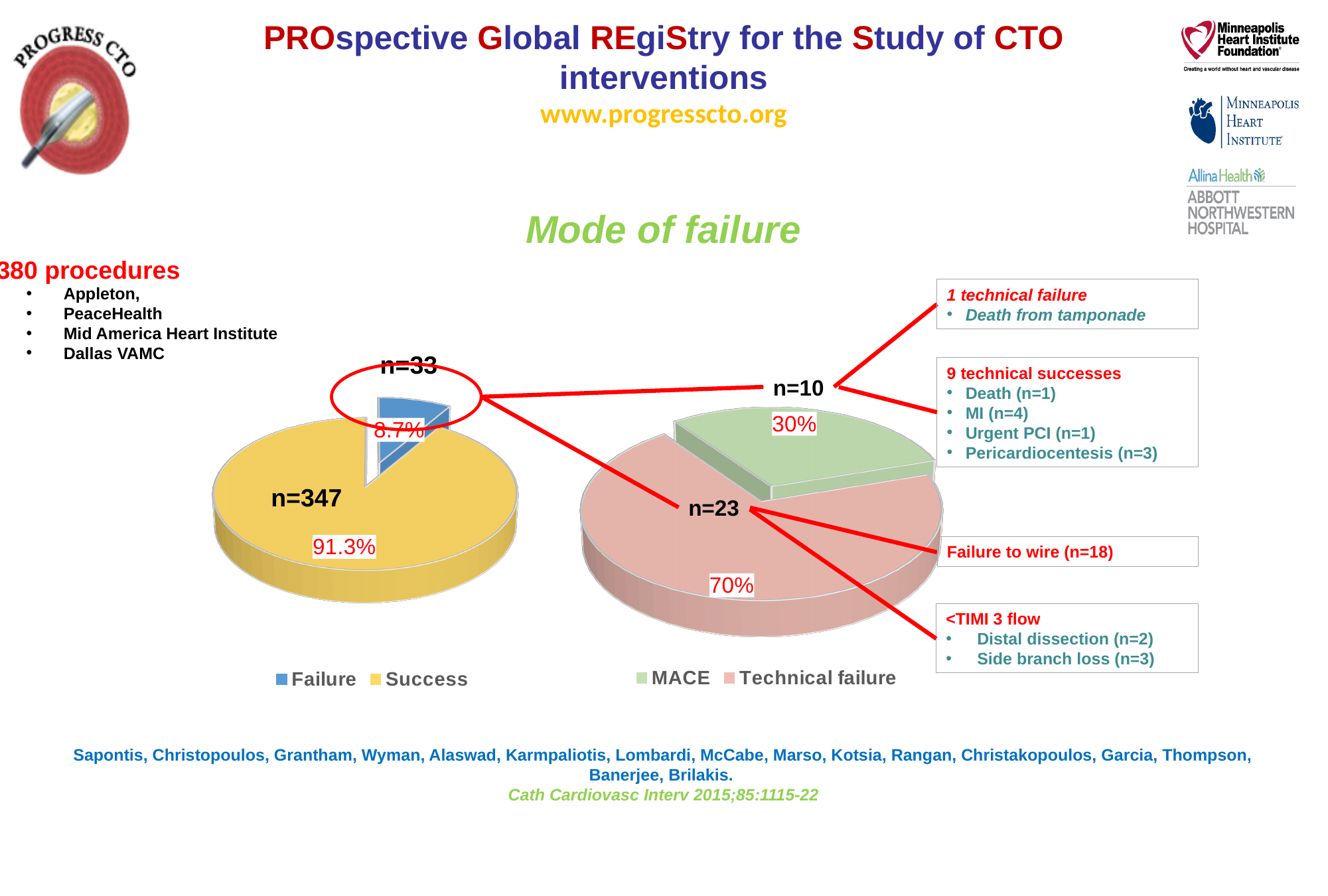
In the left pie chart, what percentage is shown for the Success slice? 91.3% In the right pie chart, what is the difference in n between Technical failure and MACE? 13 How many slices does the right pie chart have? 2 In the right pie chart, what percentage is shown for the MACE slice? 30% What type of chart is the left chart on the slide? pie chart In the left pie chart, what is the n value for the Success slice? n=347 In the left pie chart, what percentage is shown for the Failure slice? 8.7% In the left pie chart, what is the n value for the Failure slice? n=33 In the left pie chart, which slice is larger, Failure or Success? Success What are the two legend entries of the right pie chart? MACE and Technical failure In the right pie chart, what is the n value for the MACE slice? n=10 In the right pie chart, what percentage is shown for the Technical failure slice? 70%